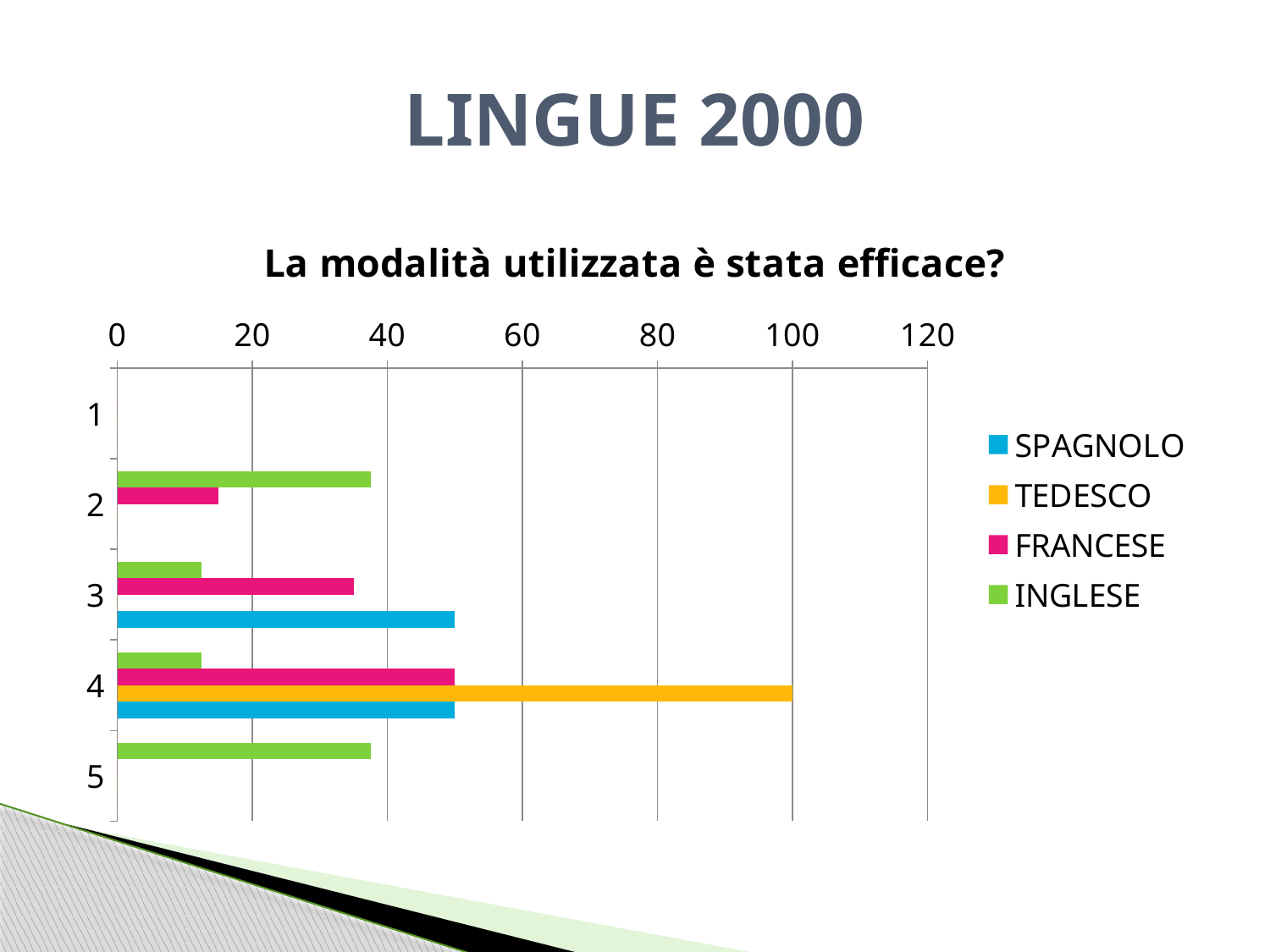
What is the value for TEDESCO in category 4? 100 In category 3, which is larger: FRANCESE or INGLESE? FRANCESE What kind of chart is shown on the slide? bar chart Is the value for INGLESE in category 2 greater or less than 20? greater How many series does the legend list? 4 Which series has the longest bar in category 4? TEDESCO In category 2, which is larger: INGLESE or FRANCESE? INGLESE What is the title of the chart? La modalità utilizzata è stata efficace? How many categories are shown on the vertical axis? 5 Is the value for SPAGNOLO in category 3 greater or less than 40? greater Is the value for TEDESCO in category 4 greater or less than 80? greater